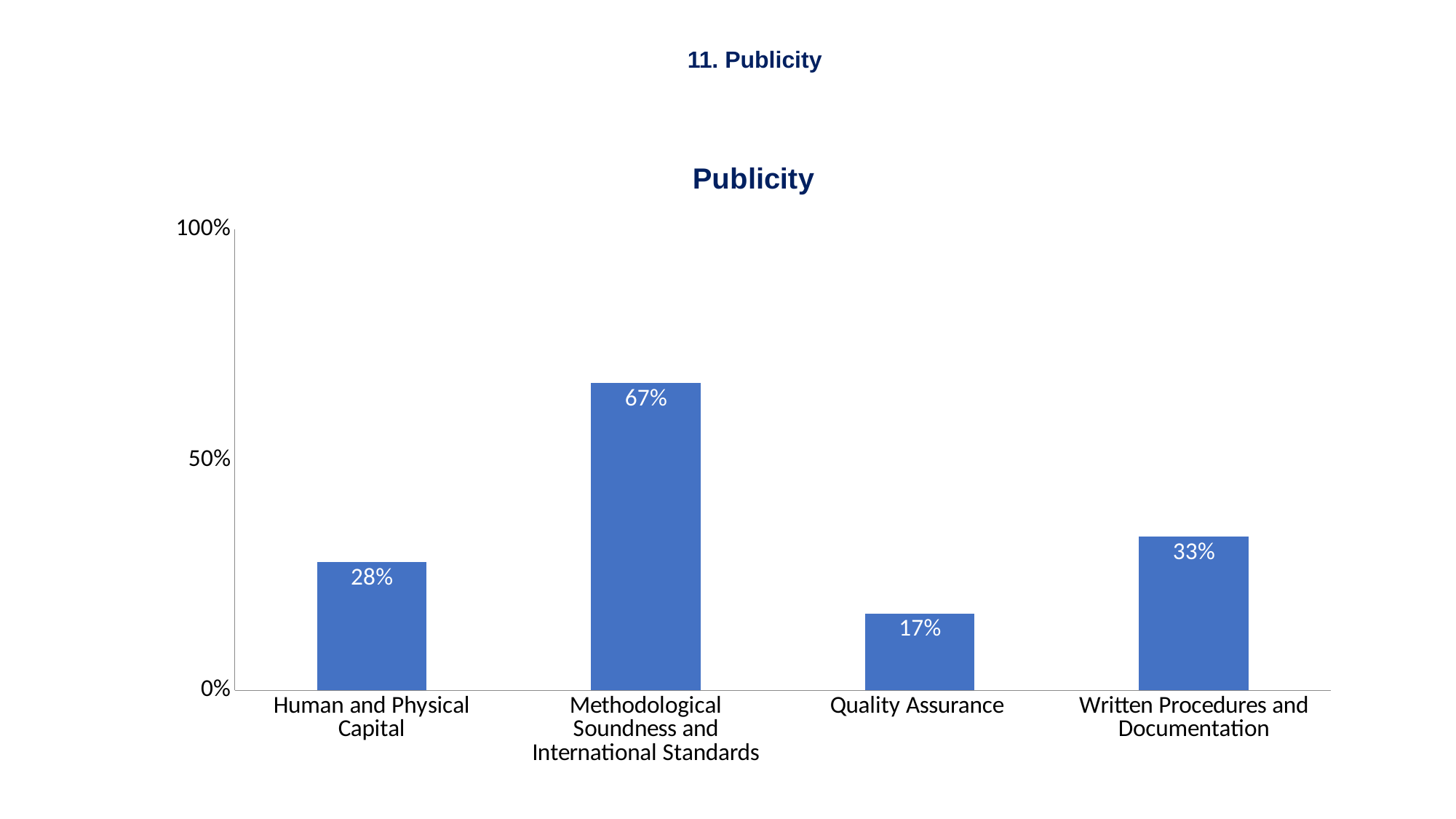
Which category has the highest value? Methodological Soundness and International Standards What is the value for Quality Assurance? 17% Which is larger, the value for Human and Physical Capital or the value for Written Procedures and Documentation? Written Procedures and Documentation How many categories are shown in the chart? 4 What is the value for Human and Physical Capital? 28% What is the difference between the values for Methodological Soundness and International Standards and Written Procedures and Documentation? 34% Is the value for Methodological Soundness and International Standards greater or less than 50%? greater What is the title of the chart? Publicity What kind of chart is shown? bar chart Which category has the lowest value? Quality Assurance What is the value for Written Procedures and Documentation? 33% What is the value for Methodological Soundness and International Standards? 67%